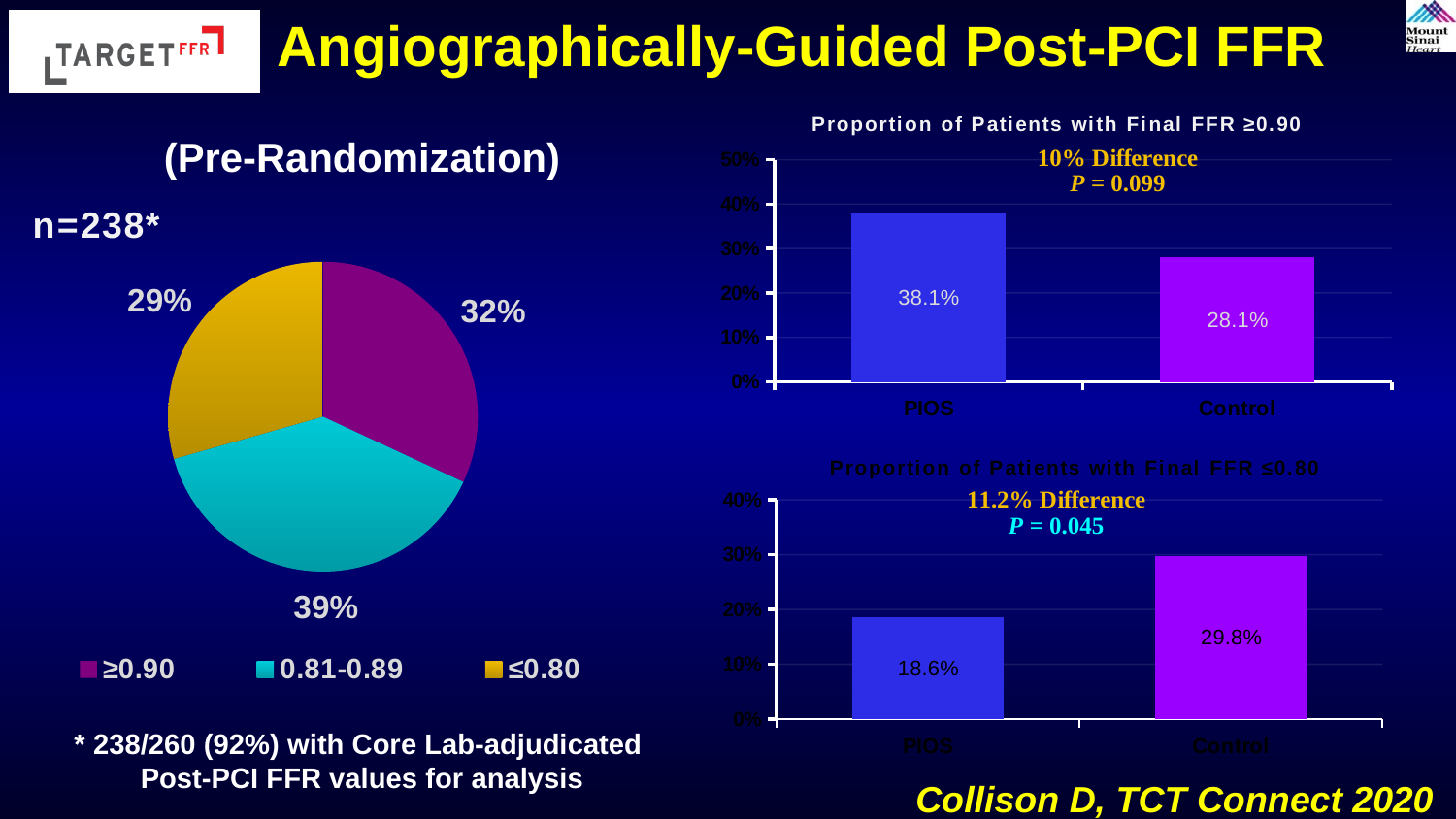
In the pie chart on the left, which FFR category has the smallest slice? ≤0.80 In the chart titled 'Proportion of Patients with Final FFR ≥0.90', which group has the higher value, PIOS or Control? PIOS In the chart titled 'Proportion of Patients with Final FFR ≤0.80', which group has the lower value? PIOS What kind of chart is used for 'Proportion of Patients with Final FFR ≥0.90'? Bar chart In the chart titled 'Proportion of Patients with Final FFR ≥0.90', what is the value for Control? 28.1% In the chart titled 'Proportion of Patients with Final FFR ≤0.80', what is the difference between the Control and PIOS values? 11.2% In the pie chart on the left, what share of patients had a post-PCI FFR of 0.81-0.89? 39% In the pie chart on the left, what share of patients had a post-PCI FFR ≤0.80? 29% In the chart titled 'Proportion of Patients with Final FFR ≤0.80', what is the value for PIOS? 18.6% In the chart titled 'Proportion of Patients with Final FFR ≥0.90', what is the value for PIOS? 38.1% How many categories does the legend of the pie chart on the left list? 3 In the pie chart on the left, which FFR category has the largest slice? 0.81-0.89